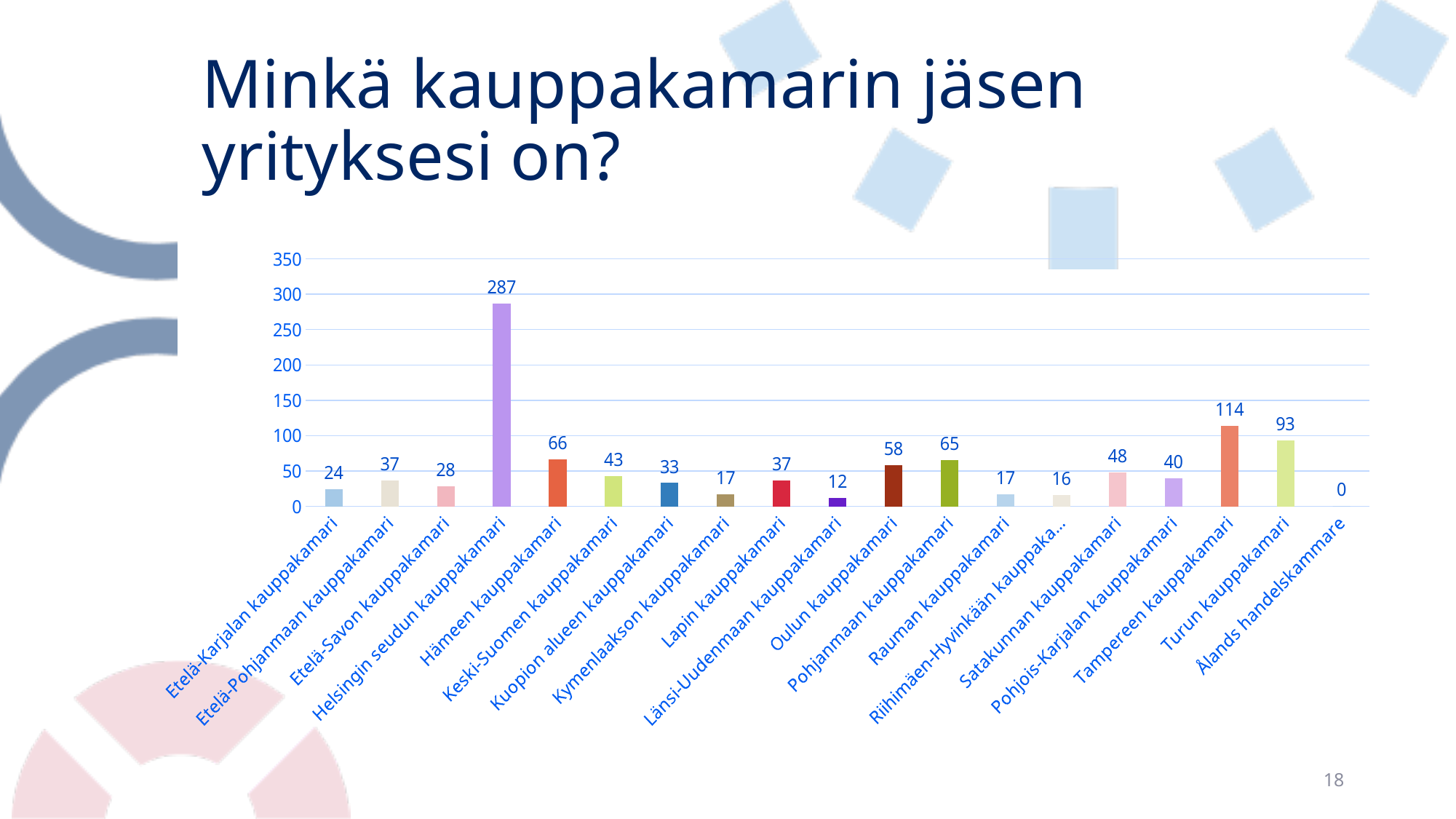
What is the difference between the values for Tampereen kauppakamari and Turun kauppakamari? 21 What kind of chart is shown on the slide? bar chart What is the value for Tampereen kauppakamari? 114 How many categories are shown on the x axis? 19 What is the value for Oulun kauppakamari? 58 What is the title of the slide? Minkä kauppakamarin jäsen yrityksesi on? Which is larger, the value for Hämeen kauppakamari or the value for Pohjanmaan kauppakamari? Hämeen kauppakamari Which category has the lowest value? Ålands handelskammare What is the value for Helsingin seudun kauppakamari? 287 Is the value for Turun kauppakamari greater or less than 100? less What is the value for Ålands handelskammare? 0 Which category has the highest value? Helsingin seudun kauppakamari